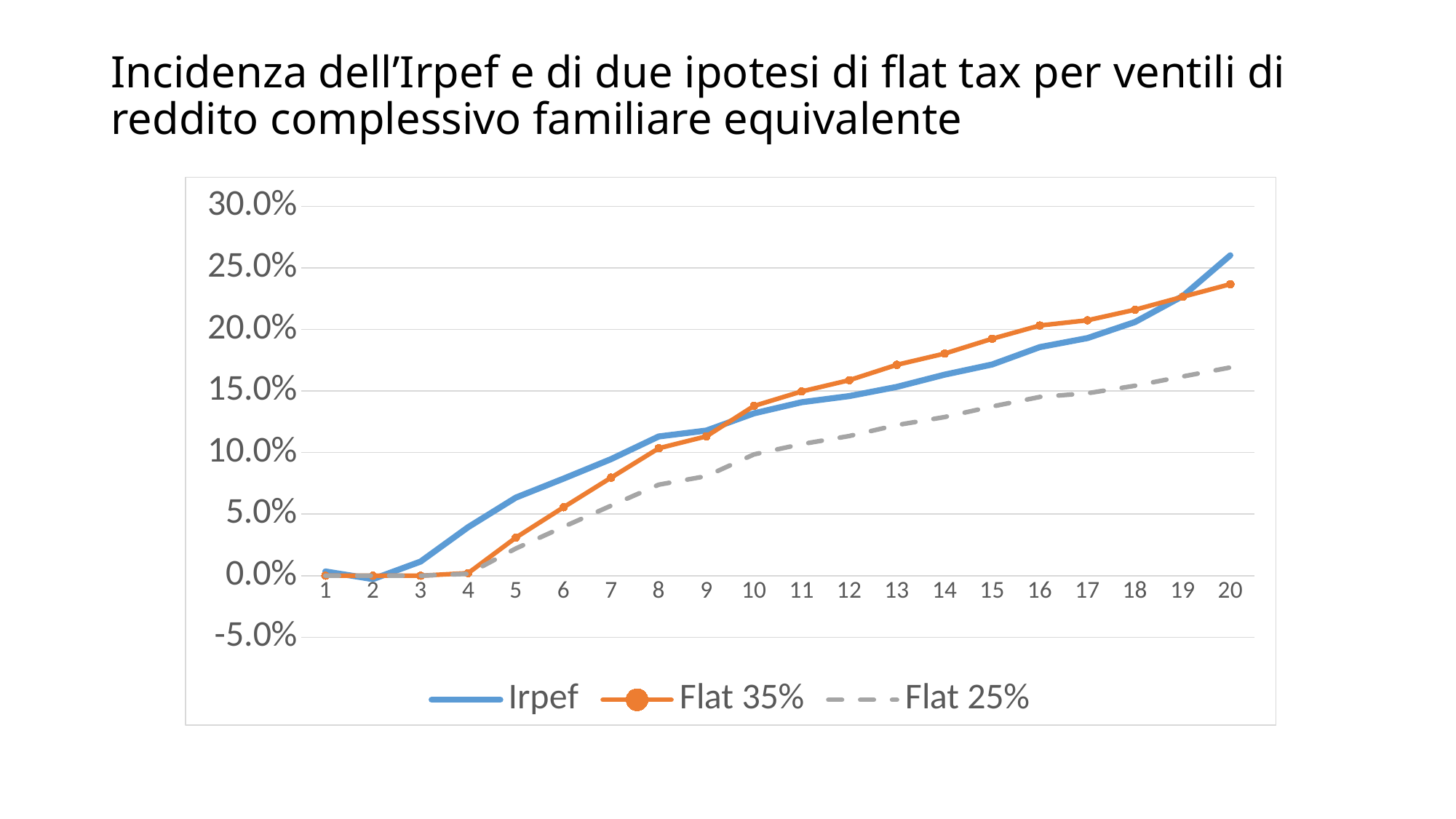
Which series has the lowest value at ventile 20? Flat 25% How many series does the legend list? 3 Which series is plotted as a dashed grey line? Flat 25% What kind of chart is shown on the slide? line chart Which series has the highest value at ventile 20? Irpef At ventile 15, which is larger: the Irpef value or the Flat 35% value? Flat 35% Is the value for Flat 25% at ventile 20 greater or less than 20.0%? less Which series is plotted in blue? Irpef At ventile 5, which is larger: the Irpef value or the Flat 35% value? Irpef Do the values of the Irpef series rise or fall from ventile 5 to ventile 20? rise How many ventili (points) are plotted along the x axis? 20 Is the value for Flat 35% at ventile 10 greater or less than 10.0%? greater